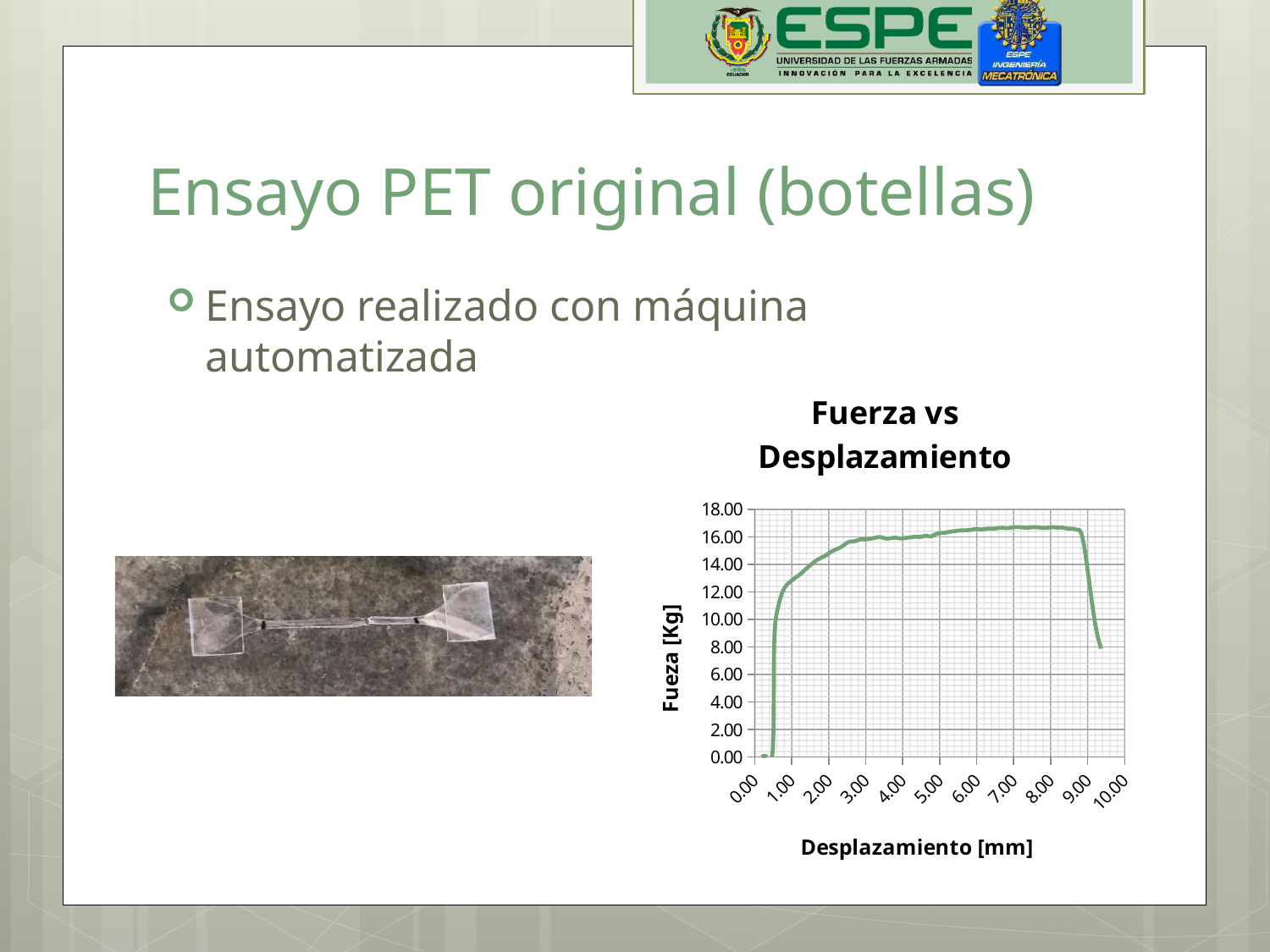
In the 'Fuerza vs Desplazamiento' chart, does the force rise or fall after the displacement passes about 9.00 mm? fall In the 'Fuerza vs Desplazamiento' chart, is the force at a displacement of 2.00 mm greater or less than 12.00 Kg? greater What is the label of the x axis of the 'Fuerza vs Desplazamiento' chart? Desplazamiento [mm] What is the highest value shown on the y axis of the 'Fuerza vs Desplazamiento' chart? 18.00 In the 'Fuerza vs Desplazamiento' chart, is the force at 6.00 mm larger or smaller than the force at 1.00 mm? larger What is the title of the chart on the slide? Fuerza vs Desplazamiento In the 'Fuerza vs Desplazamiento' chart, is the force at a displacement of 3.00 mm greater or less than 14.00 Kg? greater What kind of chart is the 'Fuerza vs Desplazamiento' chart? line chart In the 'Fuerza vs Desplazamiento' chart, is the force at a displacement of 5.00 mm greater or less than 14.00 Kg? greater In the 'Fuerza vs Desplazamiento' chart, does the force rise or fall as displacement increases from 1.00 mm to 4.00 mm? rise